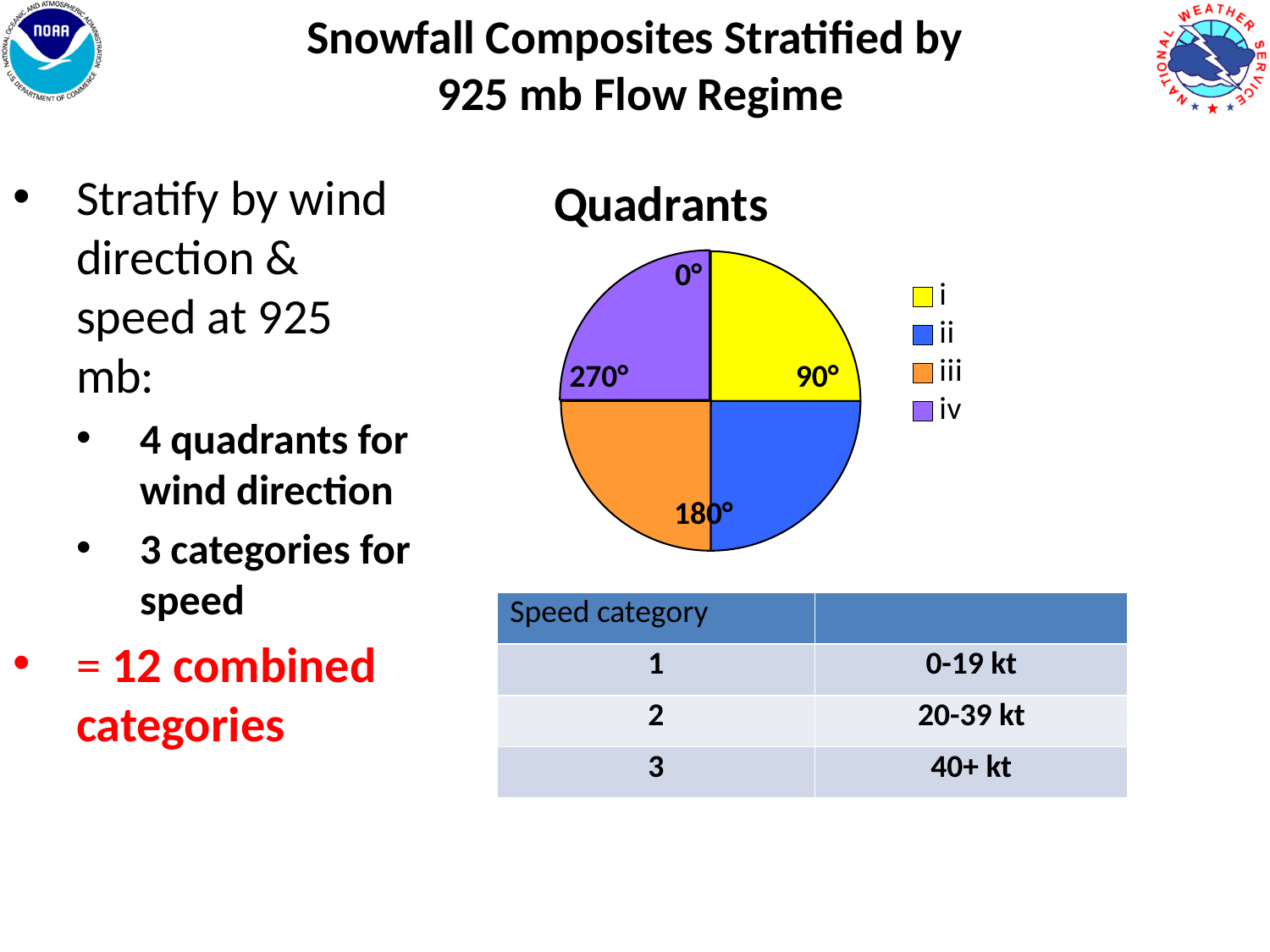
What degree label is printed at the top of the "Quadrants" pie chart? 0° How many entries does the legend of the "Quadrants" chart list? 4 How many slices does the "Quadrants" pie chart have? 4 What degree label is printed on the left side of the "Quadrants" pie chart? 270° In the "Quadrants" pie chart, is slice ii larger than slice iv, or are they the same size? the same size What colour is slice i in the "Quadrants" pie chart? yellow Which quadrant in the "Quadrants" pie chart lies between the 0° and 90° labels? i What kind of chart is the "Quadrants" chart? pie chart What is the title of the pie chart on the slide? Quadrants Which quadrant in the "Quadrants" pie chart lies between the 180° and 270° labels? iii